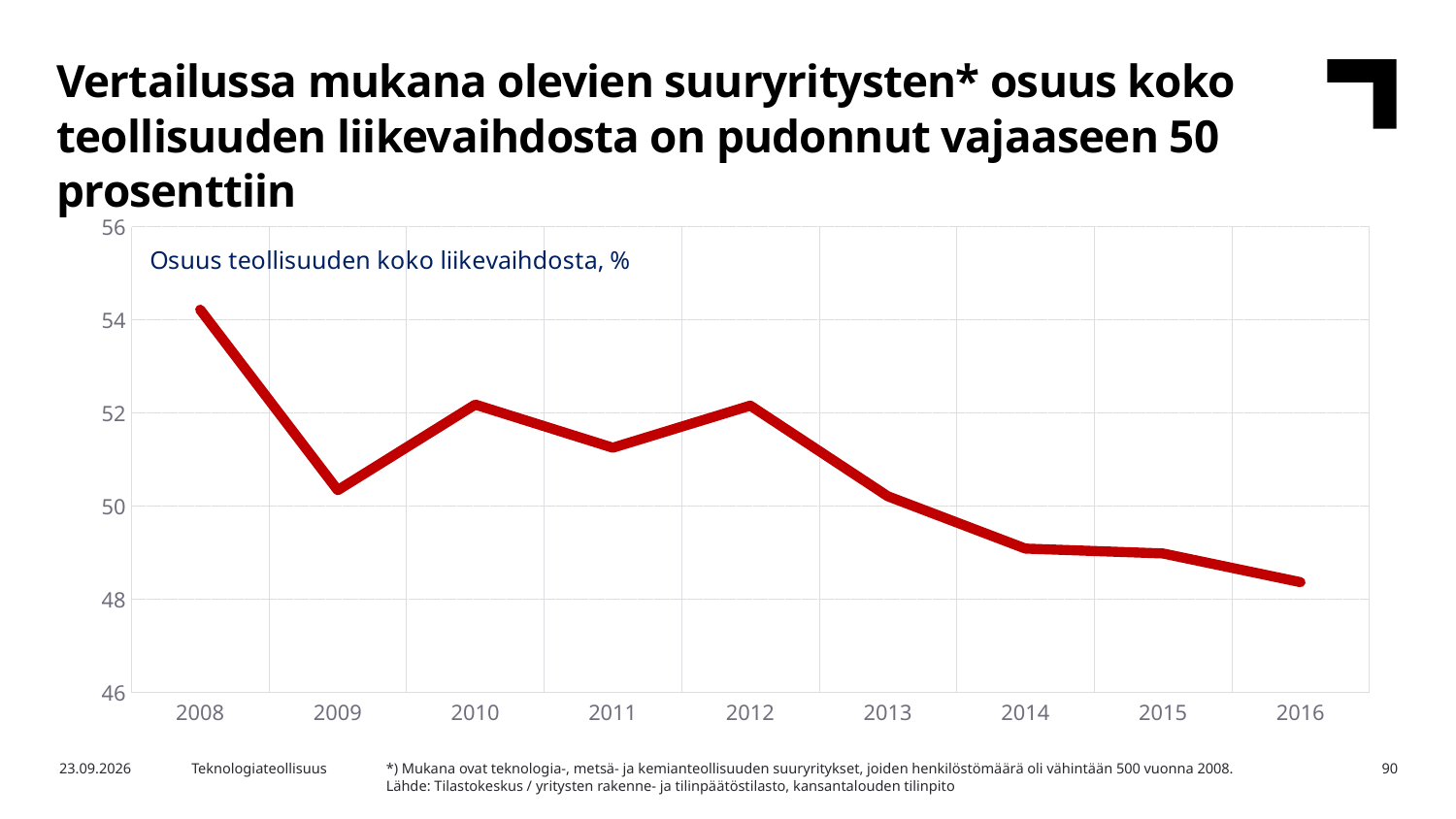
Which is larger, the value for 2008 or the value for 2009? 2008 Is the value for 2008 greater or less than 54? greater Is the value for 2014 greater or less than 50? less How many years are plotted along the x axis of the chart? 9 Which year has the highest value in the chart? 2008 Which year has the lowest value in the chart? 2016 What kind of chart is shown on the slide? line chart Which is larger, the value for 2013 or the value for 2016? 2013 Is the value for 2010 greater or less than 52? greater What is the label shown inside the chart area describing the plotted series? Osuus teollisuuden koko liikevaihdosta, % Overall, do the values rise or fall from 2008 to 2016? fall